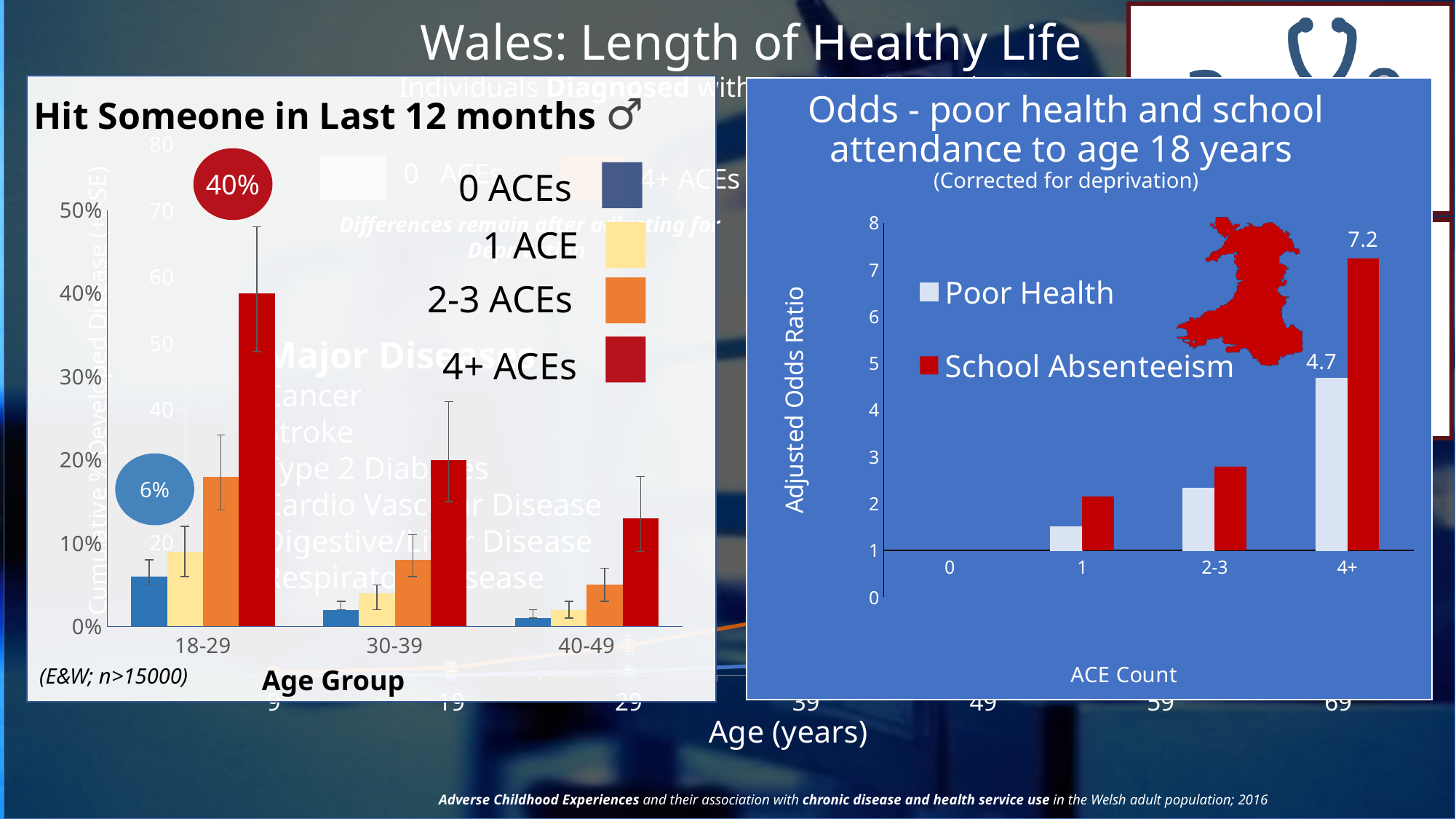
In the 'Hit Someone in Last 12 months' chart, is the value for 4+ ACEs in the 30-39 age group greater or less than 10%? greater In the 'Odds - poor health and school attendance to age 18 years' chart, what is the adjusted odds ratio for Poor Health at an ACE count of 4+? 4.7 In the 'Hit Someone in Last 12 months' chart, what kind of chart is shown? bar chart In the 'Odds - poor health and school attendance to age 18 years' chart, what is the difference between the School Absenteeism and Poor Health values at an ACE count of 4+? 2.5 In the 'Odds - poor health and school attendance to age 18 years' chart, do the values rise or fall as the ACE count increases? rise In the 'Hit Someone in Last 12 months' chart, what is the value for 0 ACEs in the 18-29 age group? 6% In the 'Hit Someone in Last 12 months' chart, what is the difference between the 4+ ACEs and 0 ACEs values in the 18-29 age group? 34% In the 'Hit Someone in Last 12 months' chart, how many series does the legend list? 4 In the 'Odds - poor health and school attendance to age 18 years' chart, what is the adjusted odds ratio for School Absenteeism at an ACE count of 4+? 7.2 In the 'Hit Someone in Last 12 months' chart, how many age groups are shown on the x axis? 3 In the 'Hit Someone in Last 12 months' chart, what is the value for 4+ ACEs in the 18-29 age group? 40% In the 'Hit Someone in Last 12 months' chart, which age group has the highest value for 4+ ACEs? 18-29